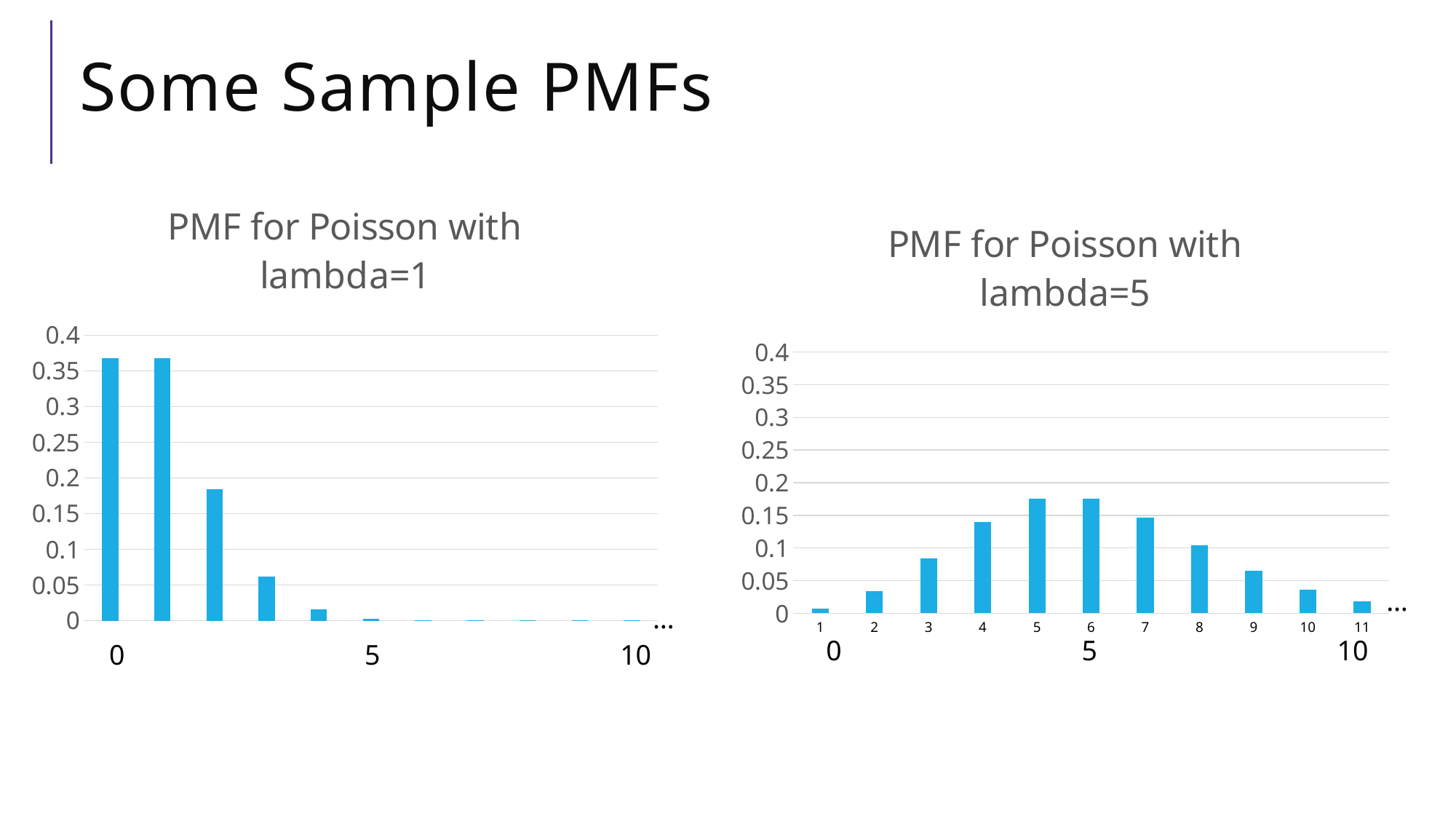
What kind of chart is the 'PMF for Poisson with lambda=1' chart? bar chart In the 'PMF for Poisson with lambda=1' chart, which is larger, the value at x = 2 or the value at x = 3? x = 2 In the 'PMF for Poisson with lambda=5' chart, is the value of the bar labelled 4 greater or less than 0.1? greater In the 'PMF for Poisson with lambda=1' chart, is the value at x = 0 greater or less than 0.3? greater In the 'PMF for Poisson with lambda=1' chart, is the value at x = 4 greater or less than 0.05? less In the 'PMF for Poisson with lambda=5' chart, which bar is the lowest? the bar labelled 1 What is the title of the chart on the right of the slide? PMF for Poisson with lambda=5 How many bars are plotted in the 'PMF for Poisson with lambda=5' chart? 11 In the 'PMF for Poisson with lambda=5' chart, which is larger, the bar labelled 4 or the bar labelled 9? the bar labelled 4 In the 'PMF for Poisson with lambda=1' chart, do the values rise or fall as x increases? fall